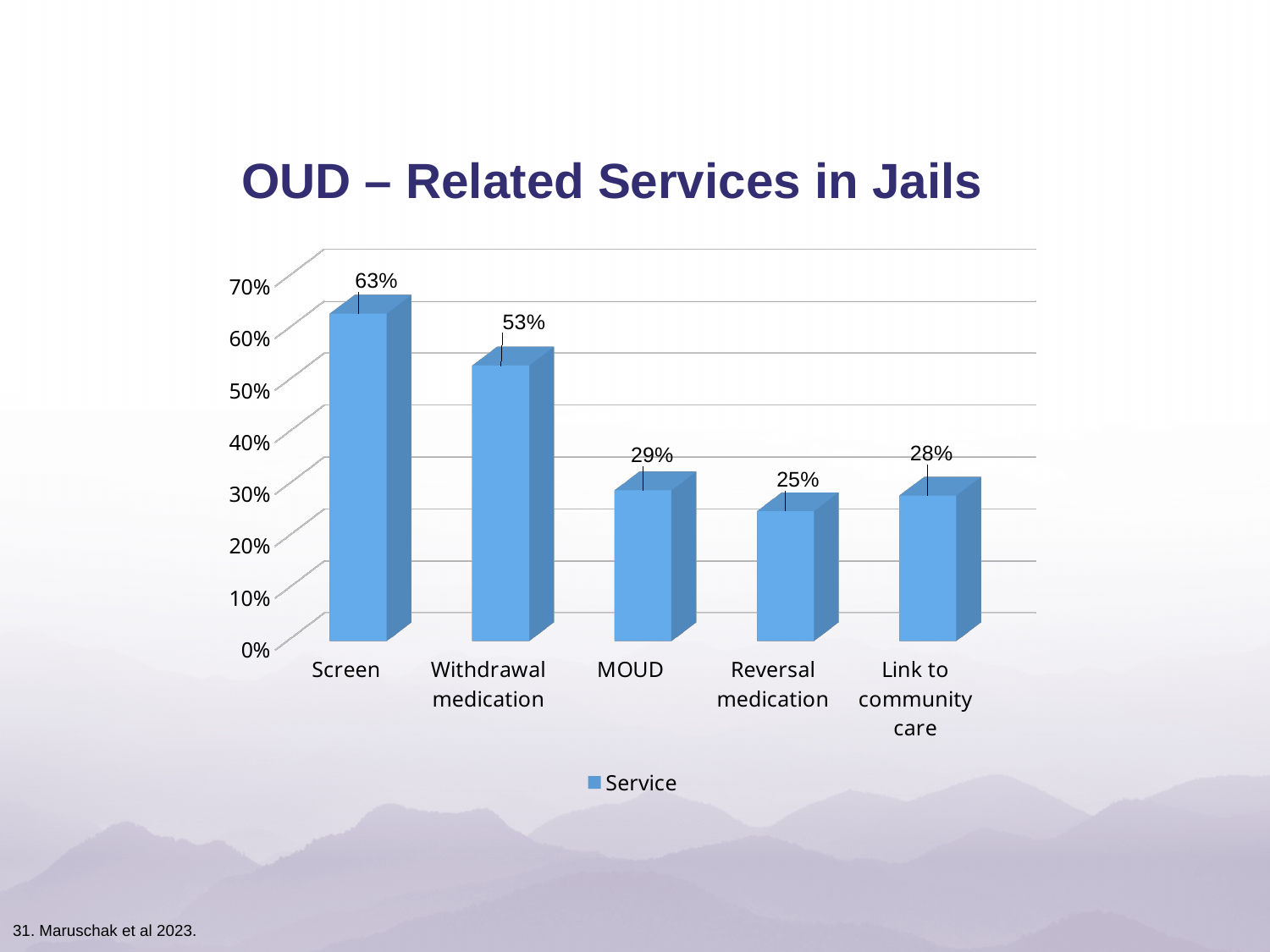
Which category has the highest value? Screen What is the value for Withdrawal medication? 53% What is the value for MOUD? 29% What is the difference between the values for Screen and Withdrawal medication? 10% Which category has the lowest value? Reversal medication What is the value for Screen? 63% What kind of chart is shown on the slide? Bar chart What is the value for Reversal medication? 25% Which is larger, the value for MOUD or the value for Link to community care? MOUD What is the title of the chart? OUD – Related Services in Jails What is the value for Link to community care? 28% How many categories are shown on the x axis? 5